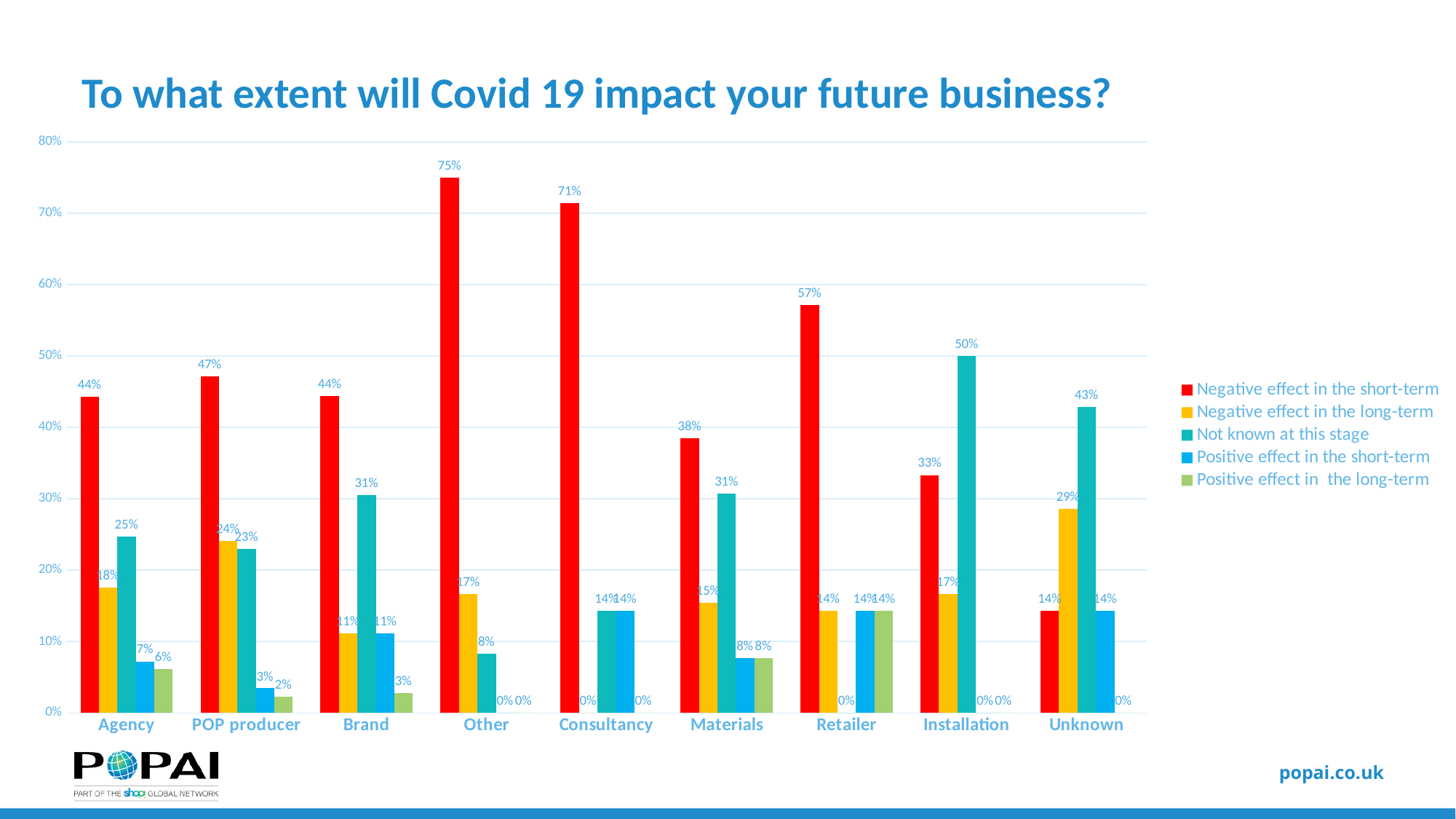
How many series does the legend list? 5 Which category has the lowest value for 'Negative effect in the short-term'? Unknown Which is larger: the 'Not known at this stage' value for Brand or for Agency? Brand Which category has the highest value for 'Negative effect in the short-term'? Other What is the value for 'Not known at this stage' for Installation? 50% What type of chart is shown on the slide? bar chart What is the difference between the 'Negative effect in the short-term' values for Other and Consultancy? 4% What is the value for 'Negative effect in the short-term' for Other? 75% Is the 'Negative effect in the short-term' value for Retailer greater or less than 50%? greater What is the value for 'Negative effect in the long-term' for Unknown? 29% How many categories are shown on the x axis? 9 What is the title of the chart? To what extent will Covid 19 impact your future business?